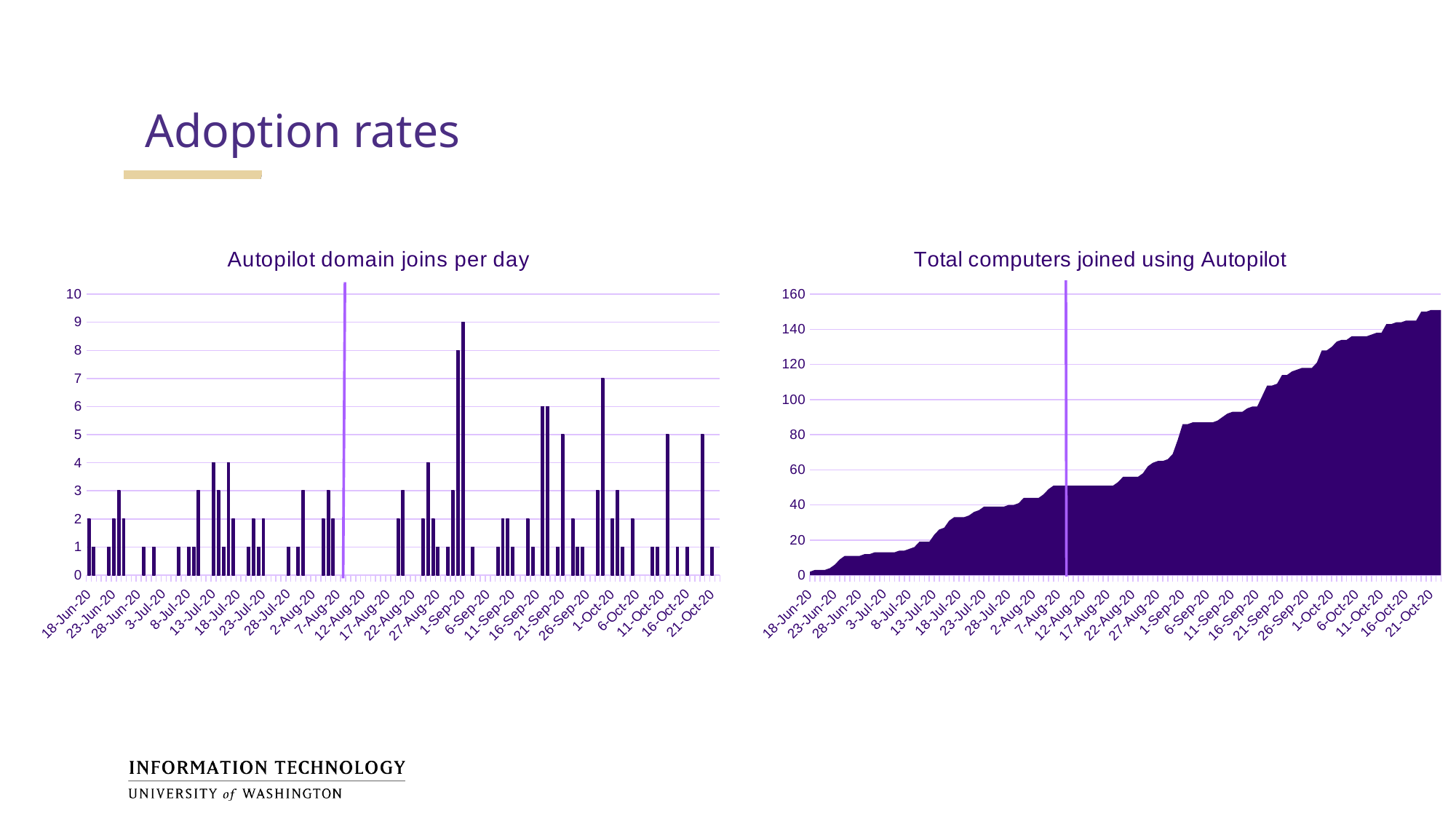
In the 'Total computers joined using Autopilot' chart, is the value at 12-Aug-20 greater or less than 60? less In the 'Autopilot domain joins per day' chart, what is the highest value shown on the y axis? 10 In the 'Total computers joined using Autopilot' chart, do the values rise or fall from 18-Jun-20 to 21-Oct-20? rise What kind of chart is the 'Total computers joined using Autopilot' chart? area chart What kind of chart is the 'Autopilot domain joins per day' chart? bar chart In the 'Total computers joined using Autopilot' chart, which date has the larger value, 18-Jun-20 or 21-Oct-20? 21-Oct-20 In the 'Autopilot domain joins per day' chart, what is the highest number of joins recorded on a single day? 9 In the 'Total computers joined using Autopilot' chart, is the value at 21-Oct-20 greater or less than 140? greater What is the title of the chart on the left? Autopilot domain joins per day In the 'Total computers joined using Autopilot' chart, is the value at 12-Aug-20 greater or less than 40? greater What is the title of the chart on the right? Total computers joined using Autopilot